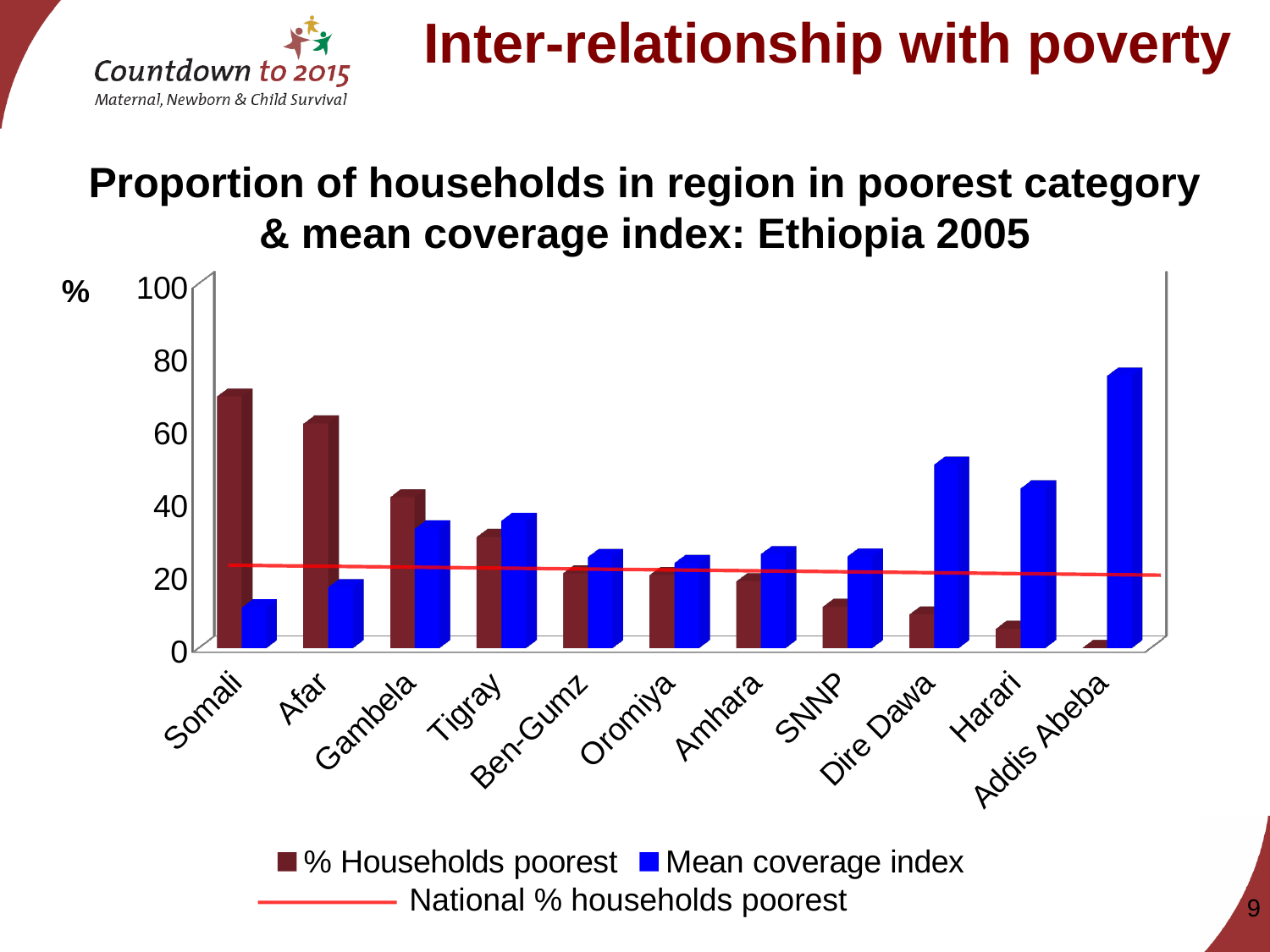
How many regions are shown along the x axis of the chart? 11 What kind of chart is shown on the slide? Bar chart Do the % Households poorest values generally rise or fall moving from Somali to Addis Abeba along the x axis? fall How many entries does the chart legend list? 3 Which region has the highest value for % Households poorest? Somali Which region has the larger Mean coverage index, Addis Abeba or Dire Dawa? Addis Abeba Is the Mean coverage index for Addis Abeba greater or less than 60? greater Is the % Households poorest value for Somali greater or less than 60? greater Which region has the lowest Mean coverage index? Somali Which region has the highest Mean coverage index? Addis Abeba Is the Mean coverage index for Somali greater or less than 20? less Which region has the lowest value for % Households poorest? Addis Abeba